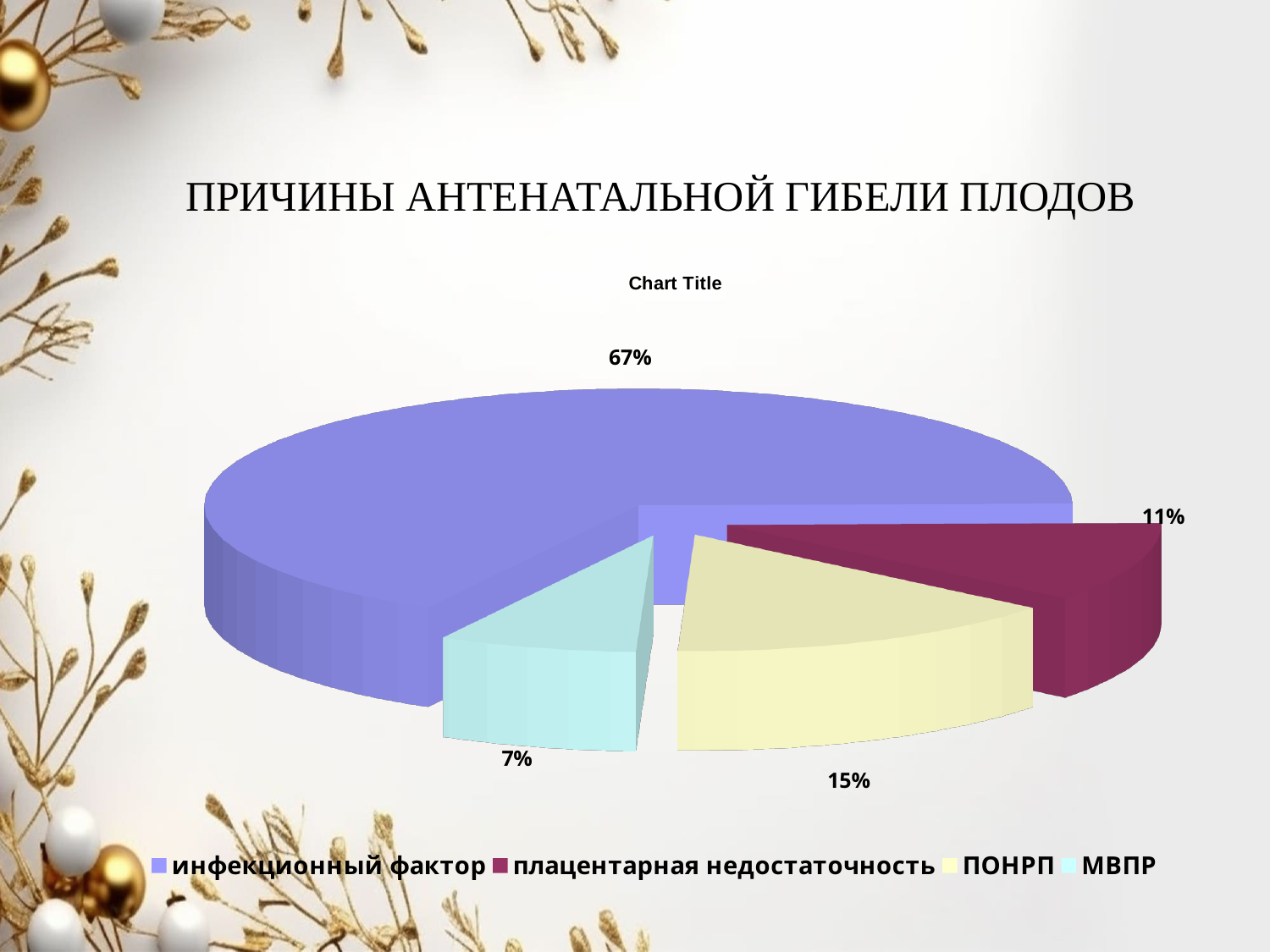
How many categories does the pie chart have? 4 Which category has the largest share of the pie? инфекционный фактор What percentage is shown for плацентарная недостаточность? 11% What percentage is shown for МВПР? 7% Which is larger, the share for ПОНРП or the share for плацентарная недостаточность? ПОНРП What percentage is shown for ПОНРП? 15% Which category has the smallest share of the pie? МВПР What is the difference in percentage points between инфекционный фактор and плацентарная недостаточность? 56 What colour is the slice for ПОНРП? Light yellow What is the difference in percentage points between ПОНРП and МВПР? 8 What percentage is shown for инфекционный фактор? 67% What type of chart is shown on the slide? Pie chart